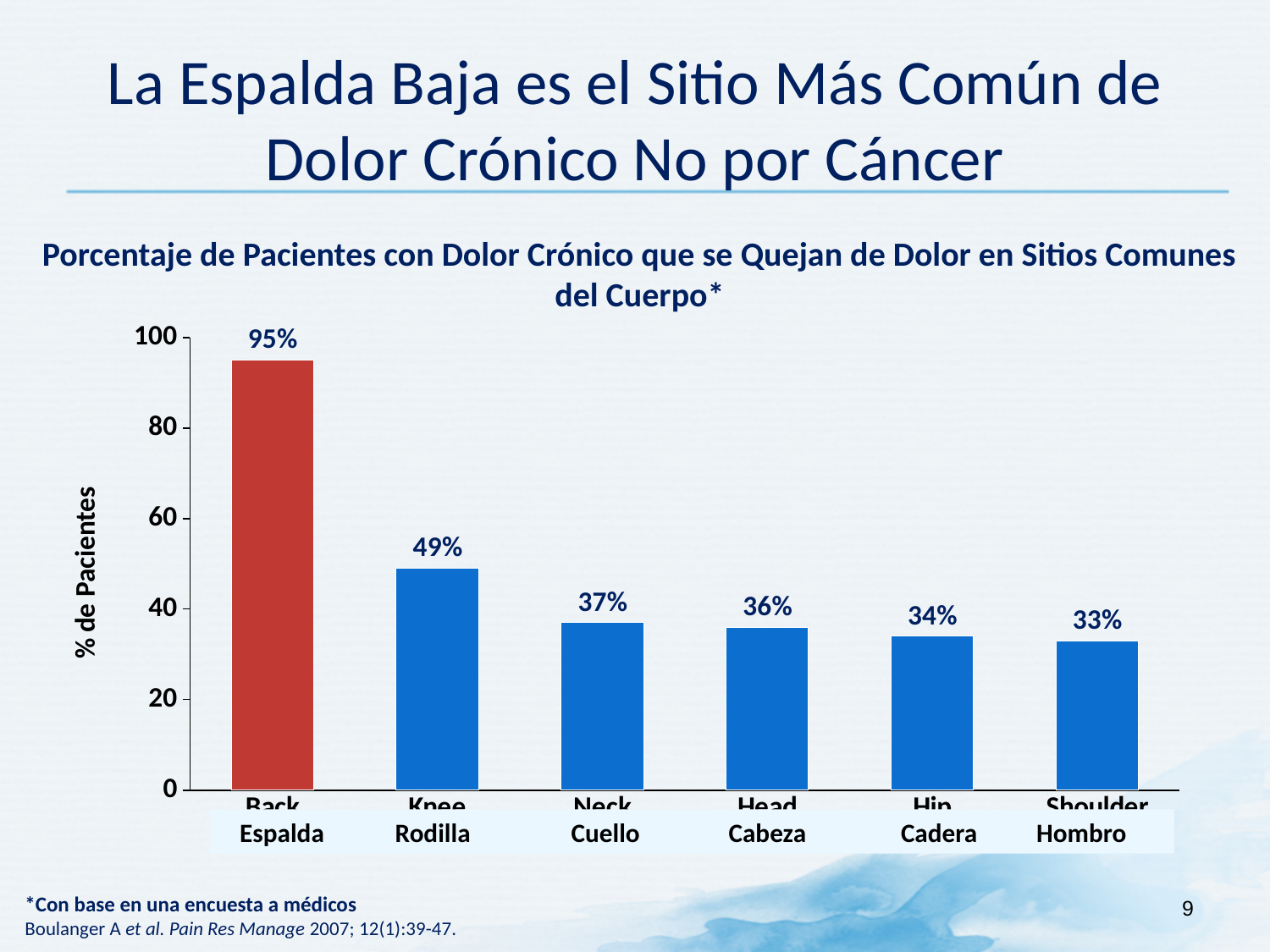
What kind of chart is shown on the slide? Bar chart What percentage of patients is shown for Espalda? 95% What is the value for Hombro? 33% Which is larger, the value for Rodilla or the value for Cabeza? Rodilla What is the label of the vertical axis? % de Pacientes What is the difference between the values for Cabeza and Cadera? 2% Which body site has the highest percentage of patients? Espalda How many body sites are shown in the chart? 6 What is the difference between the values for Espalda and Rodilla? 46% What is the value for Rodilla? 49% What is the value for Cuello? 37% Which body site has the lowest percentage of patients? Hombro